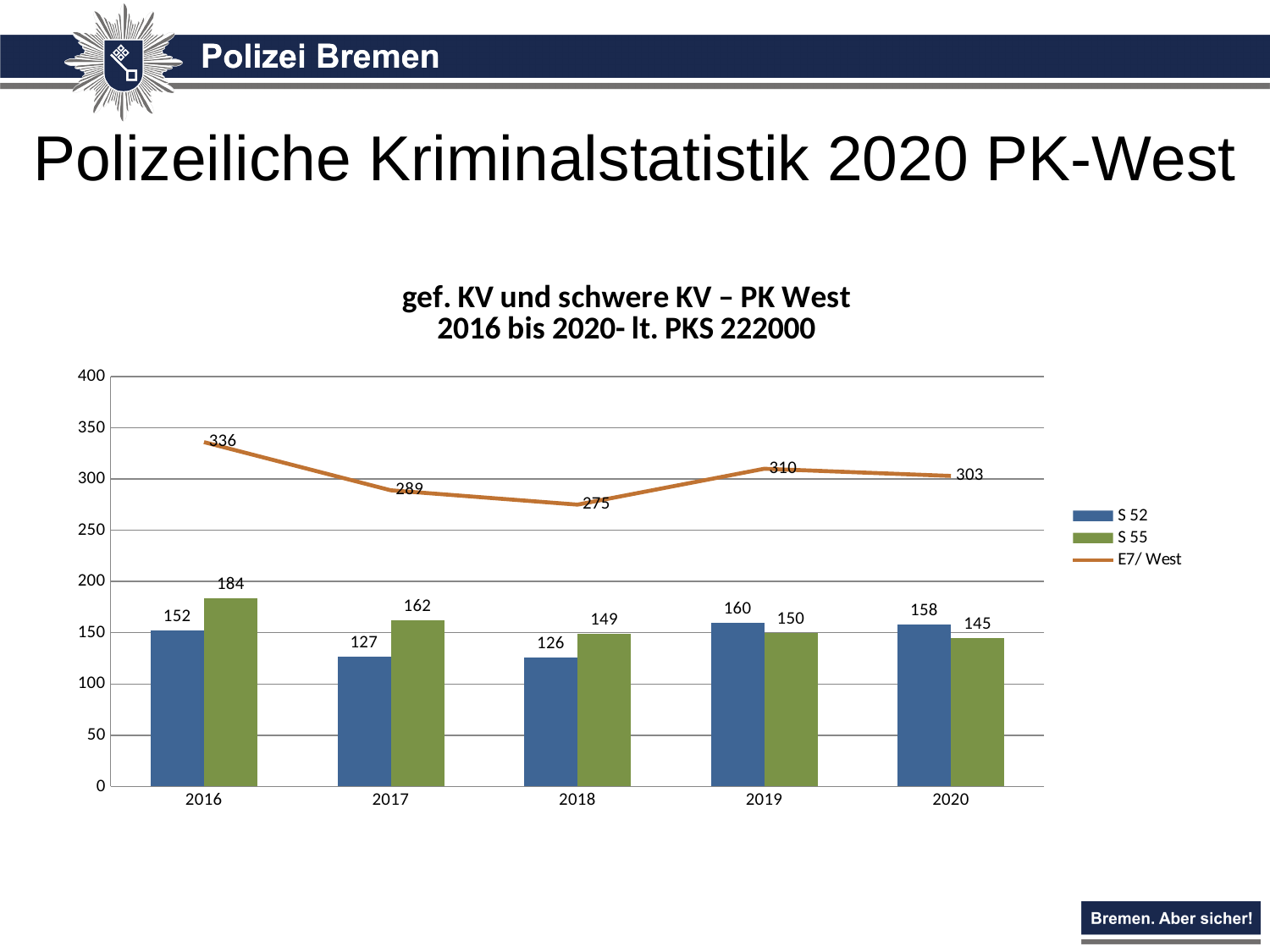
Does E7/ West rise or fall from 2016 to 2018? fall What is the value of E7/ West in 2018? 275 In which year is S 52 lowest? 2018 What is the value of S 55 in 2017? 162 What is the value of S 52 in 2016? 152 How many series does the legend list? 3 How many years are shown on the x axis? 5 In which year is E7/ West highest? 2016 Is the value of E7/ West in 2019 greater or less than 300? greater What is the difference between S 55 and S 52 in 2016? 32 Which is larger in 2020, S 52 or S 55? S 52 What is the title of the chart? gef. KV und schwere KV – PK West 2016 bis 2020- lt. PKS 222000